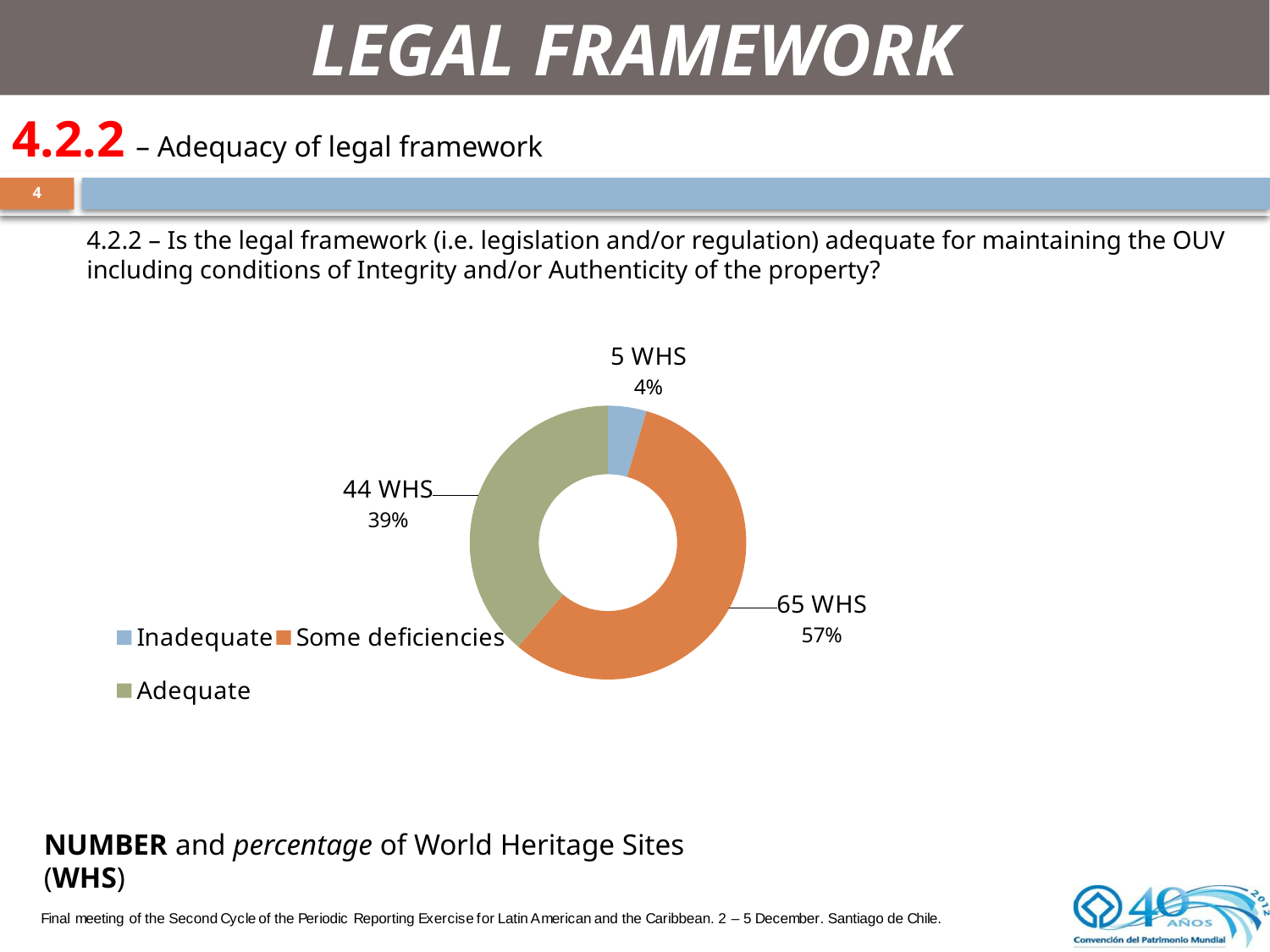
Which category has the smallest share of the chart? Inadequate Which category has more World Heritage Sites, 'Adequate' or 'Inadequate'? Adequate What is the total number of World Heritage Sites represented in the chart? 114 WHS How many World Heritage Sites are in the 'Inadequate' category? 5 WHS What is the difference in the number of WHS between 'Some deficiencies' and 'Adequate'? 21 WHS How many World Heritage Sites are in the 'Some deficiencies' category? 65 WHS Which category has the largest share of the chart? Some deficiencies What percentage of World Heritage Sites have an 'Adequate' legal framework? 39% Which colour represents the 'Adequate' category in the chart? Green What kind of chart is shown on the slide? Doughnut (pie) chart How many categories does the chart show? 3 What percentage of World Heritage Sites fall under 'Some deficiencies'? 57%